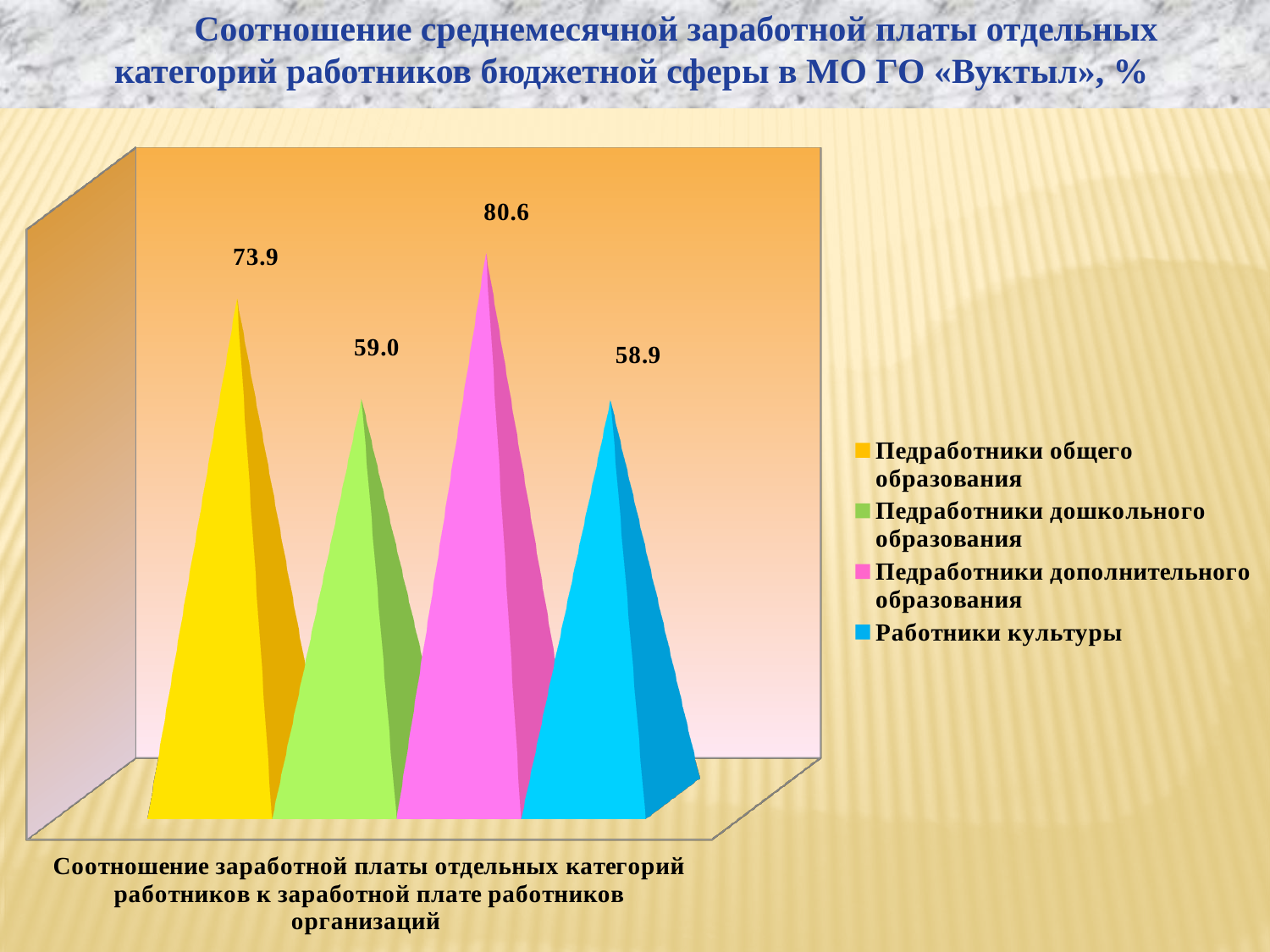
What is the value for Педработники общего образования? 73.9 What is the value for Педработники дошкольного образования? 59.0 What is the difference between the values for Педработники дополнительного образования and Педработники общего образования? 6.7 Which category has the highest value? Педработники дополнительного образования What kind of chart is shown on the slide? Bar chart What is the value for Педработники дополнительного образования? 80.6 Which is larger: the value for Педработники общего образования or the value for Педработники дошкольного образования? Педработники общего образования Which category has the lowest value? Работники культуры How many entries does the legend list? 4 What is the difference between the values for Педработники общего образования and Работники культуры? 15.0 How many categories are plotted in the chart? 4 What is the value for Работники культуры? 58.9